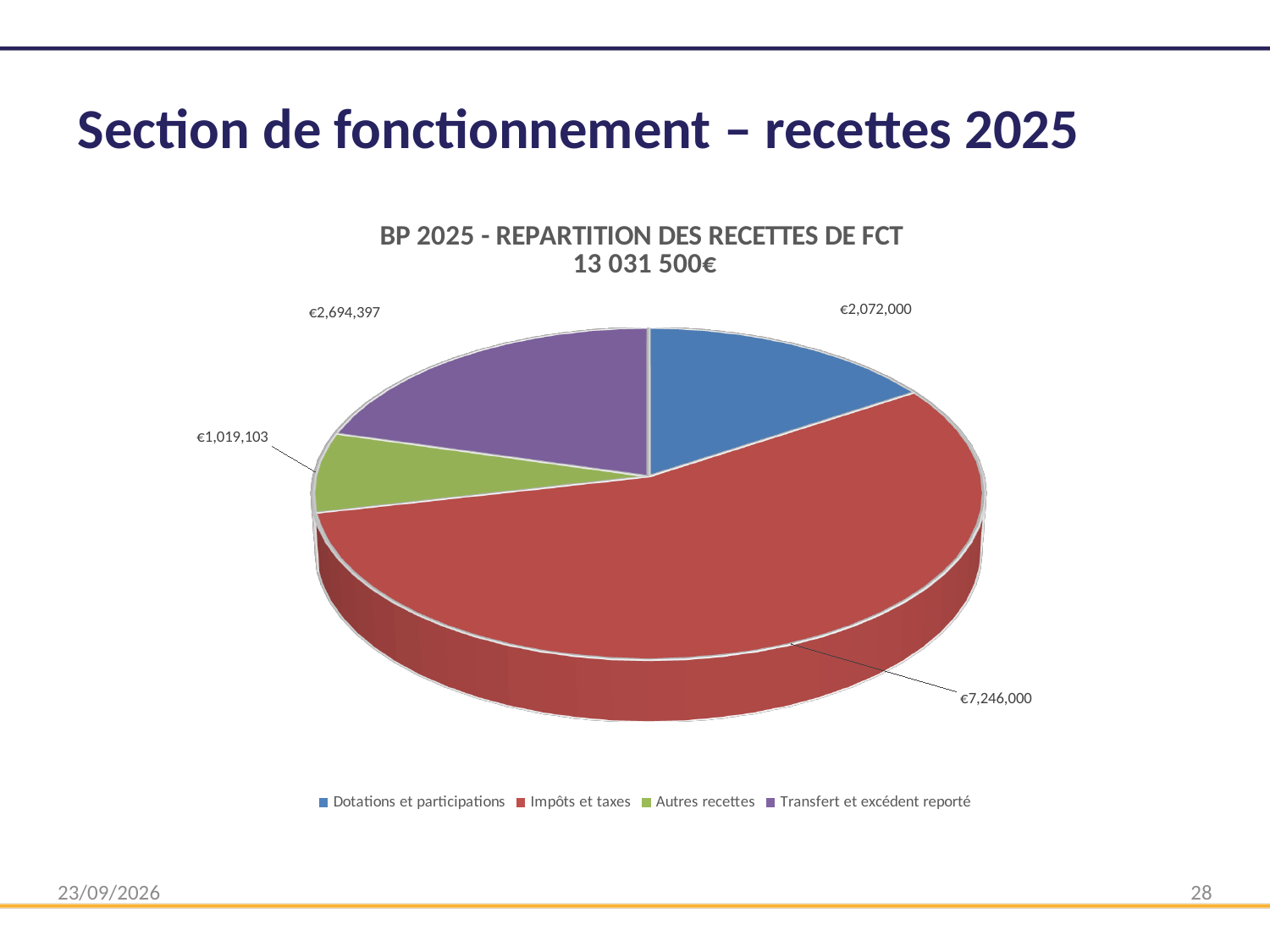
What is the difference between Impôts et taxes and Dotations et participations? €5,174,000 What colour is the slice for Impôts et taxes? Red What is the value for Dotations et participations? €2,072,000 Which category has the largest slice of the pie? Impôts et taxes How many categories does the pie chart have? 4 What total amount is stated in the chart title? 13 031 500€ Which is larger, Transfert et excédent reporté or Dotations et participations? Transfert et excédent reporté What is the value for Autres recettes? €1,019,103 What is the value for Impôts et taxes? €7,246,000 What is the value for Transfert et excédent reporté? €2,694,397 Which category has the smallest slice of the pie? Autres recettes What type of chart is shown on the slide? Pie chart